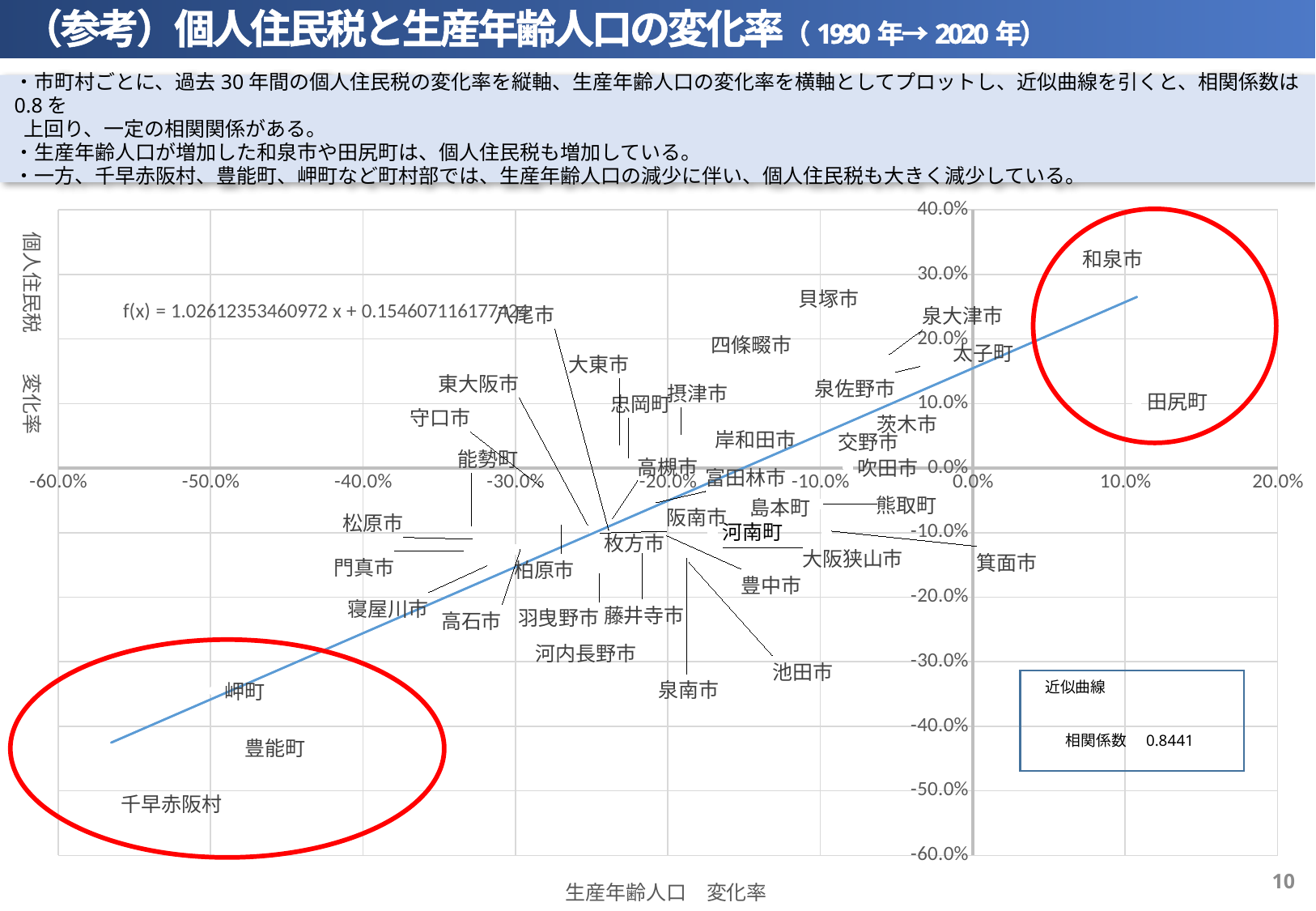
Which municipality has the highest 個人住民税 変化率 on the chart? 和泉市 Is the horizontal-axis value (生産年齢人口 変化率) for 和泉市 greater or less than 0.0%? greater Is the horizontal-axis value (生産年齢人口 変化率) for 岬町 greater or less than -40.0%? less Is the vertical-axis value (個人住民税 変化率) for 千早赤阪村 greater or less than -40.0%? less What is the title of the horizontal axis of the chart? 生産年齢人口 変化率 What is the correlation coefficient (相関係数) shown in the box on the chart? 0.8441 Which has the higher 個人住民税 変化率, 和泉市 or 千早赤阪村? 和泉市 Which municipality has the lowest 生産年齢人口 変化率 on the chart? 千早赤阪村 What kind of chart is shown on the slide? Scatter chart Does the trendline rise or fall as the x-axis value increases? Rises